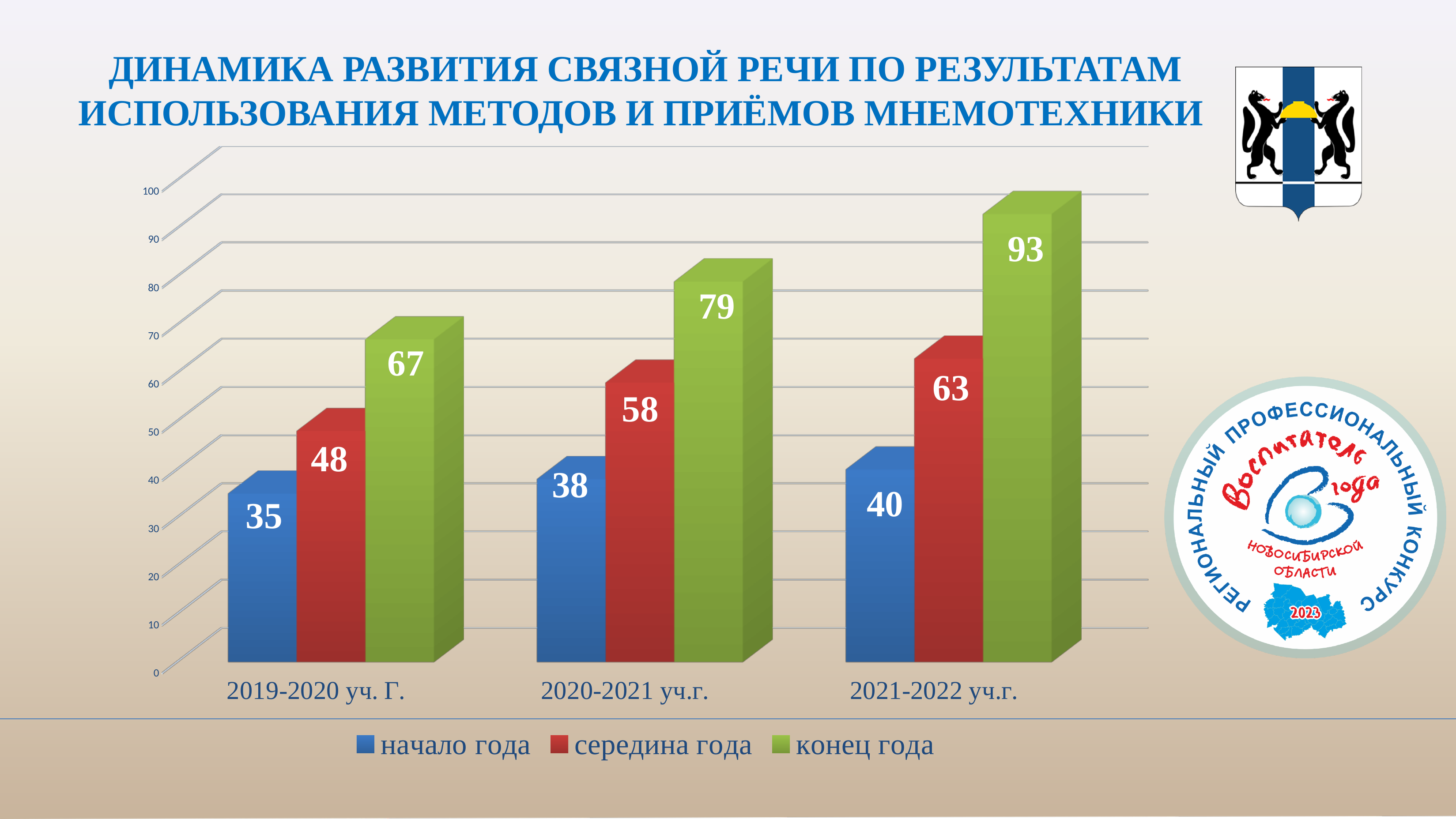
Which academic year has the highest value for "конец года"? 2021-2022 уч.г. What is the value for "начало года" in 2019-2020 уч. Г.? 35 Is the value for "конец года" in 2020-2021 уч.г. greater or less than 70? greater What kind of chart is shown on the slide? bar chart What is the value for "середина года" in 2020-2021 уч.г.? 58 How many series does the legend list? 3 What is the difference between the "конец года" and "начало года" values in 2021-2022 уч.г.? 53 Which academic year has the lowest value for "начало года"? 2019-2020 уч. Г. How many academic years are shown on the x axis? 3 What is the value for "конец года" in 2021-2022 уч.г.? 93 Which is larger: "середина года" in 2019-2020 уч. Г. or "середина года" in 2021-2022 уч.г.? 2021-2022 уч.г. Do the "конец года" values rise or fall from 2019-2020 to 2021-2022? rise